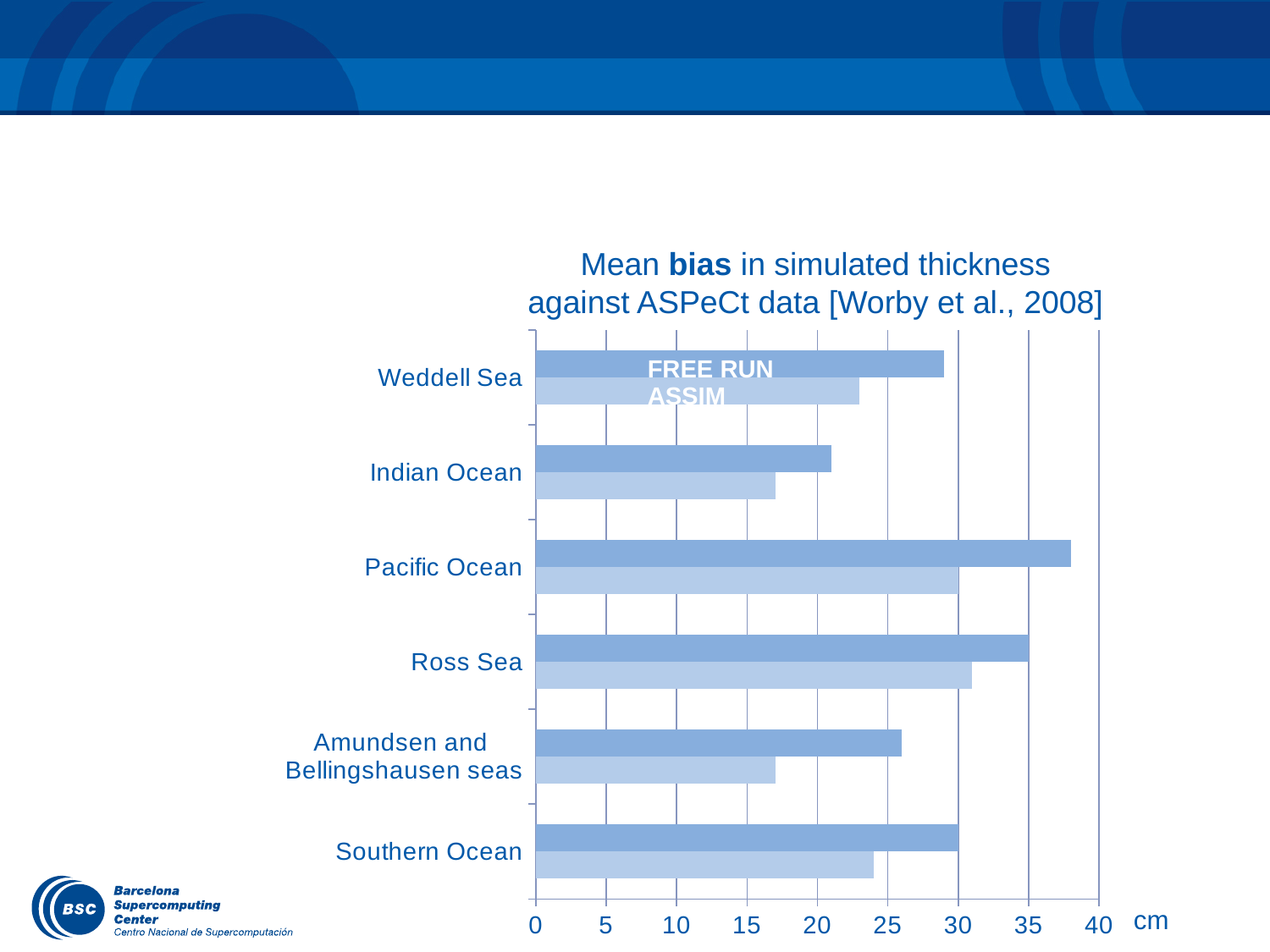
Which region has the highest FREE RUN bias? Pacific Ocean How many series does the chart show? 2 What kind of chart is shown on the slide? bar chart Which is larger, the FREE RUN value for the Ross Sea or the FREE RUN value for the Weddell Sea? Ross Sea Is the ASSIM value for the Southern Ocean greater or less than 20? greater What unit is shown on the x axis of the chart? cm Which region has the lowest FREE RUN bias? Indian Ocean Is the FREE RUN value for the Weddell Sea greater or less than 25? greater Is the ASSIM value for the Indian Ocean greater or less than 20? less How many regions (categories) are plotted on the chart? 6 For the Amundsen and Bellingshausen seas, which is larger, the FREE RUN value or the ASSIM value? FREE RUN